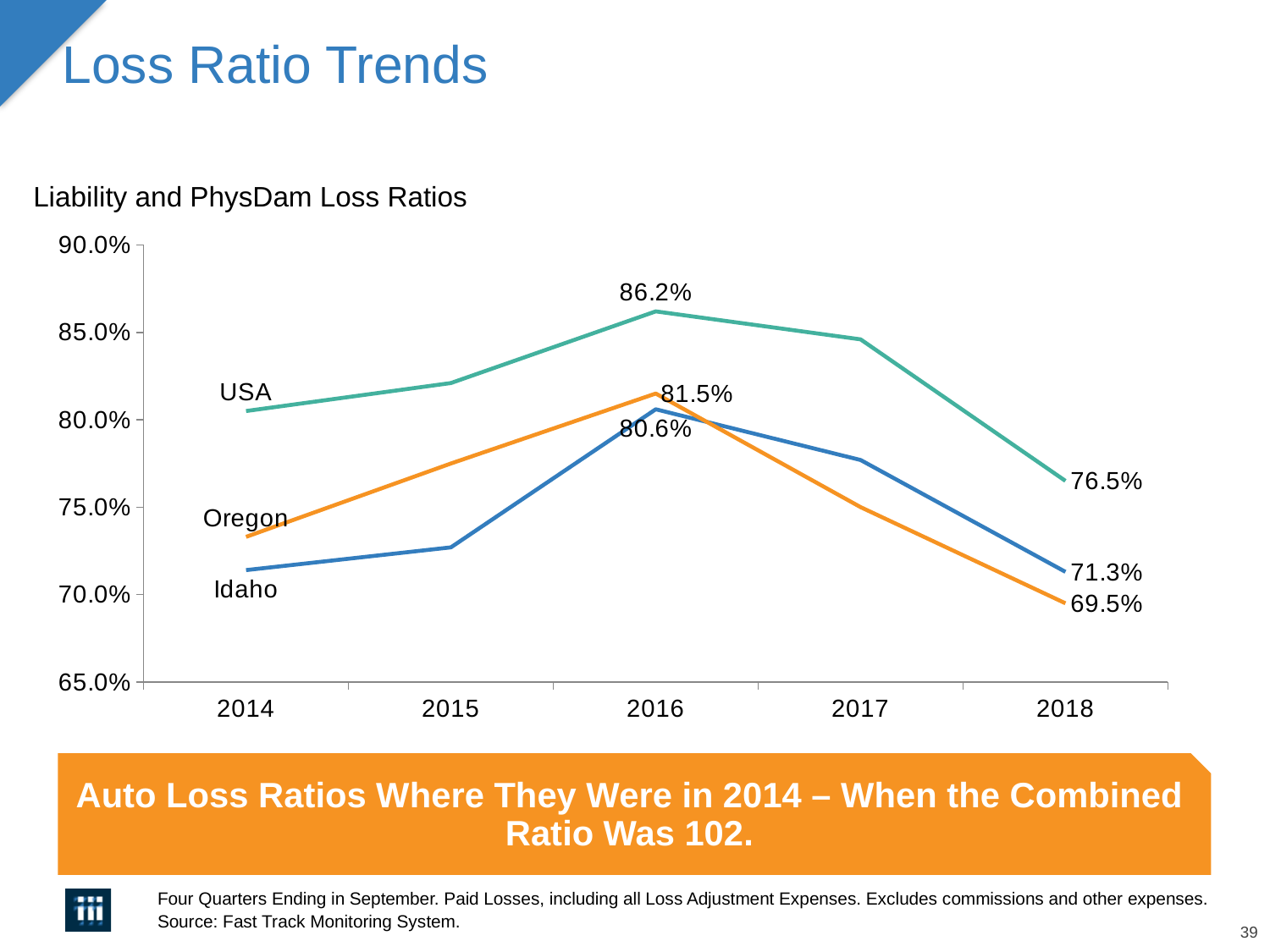
What kind of chart is shown on the slide? Line chart What is the Oregon loss ratio in 2018? 69.5% By how many percentage points did the USA loss ratio fall from 2016 to 2018? 9.7 percentage points Which series has the lowest loss ratio in 2018? Oregon Is the Idaho loss ratio in 2014 greater or less than 75.0%? less How many series (lines) are plotted on the chart? 3 What is the USA loss ratio in 2018? 76.5% What is the USA loss ratio in 2016? 86.2% Which series has the highest loss ratio in 2016? USA How many years are shown on the x axis of the chart? 5 Does the USA loss ratio rise or fall from 2016 to 2018? Fall What is the Idaho loss ratio in 2018? 71.3%